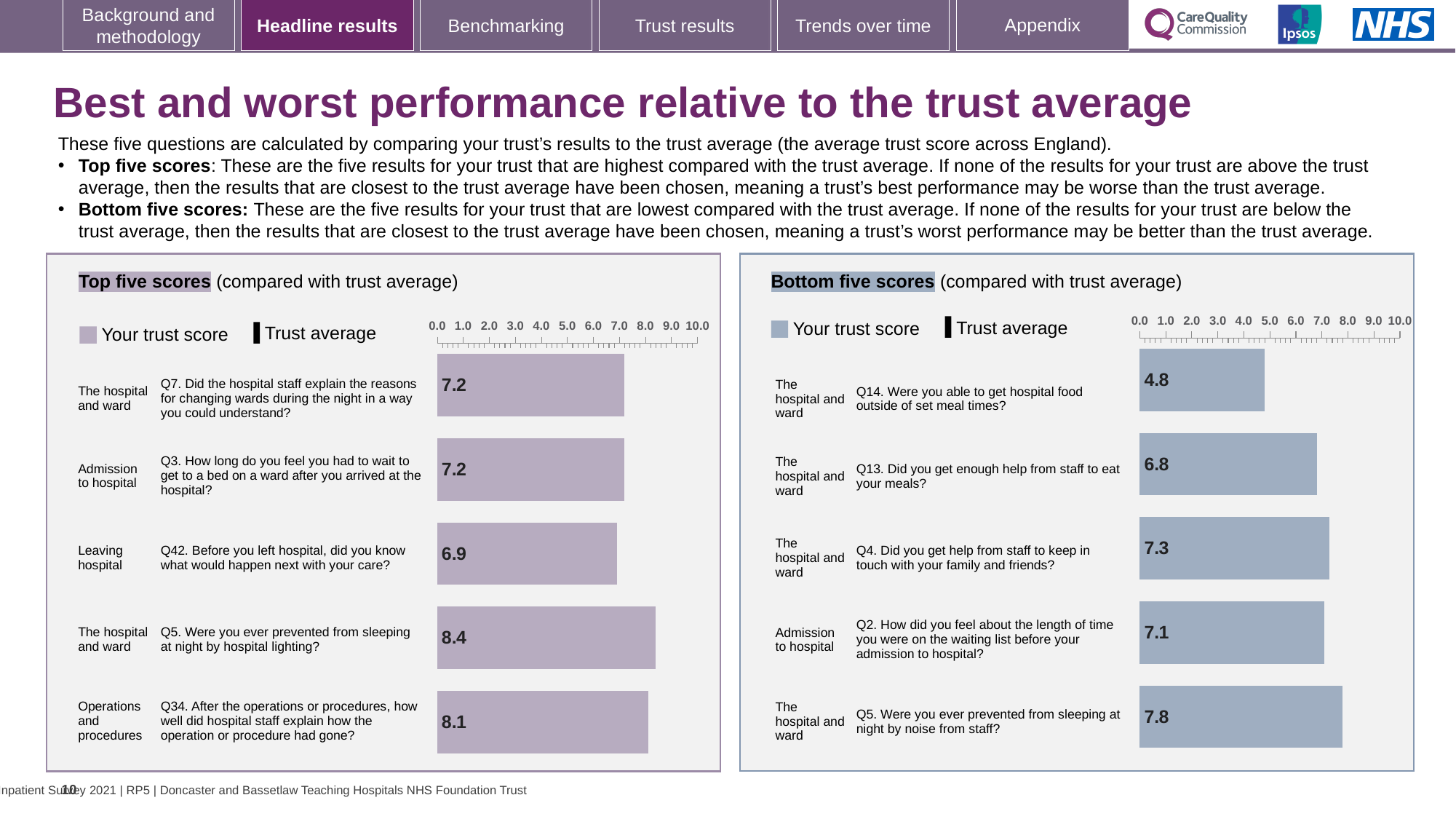
In the Bottom five scores chart, what is the difference between the score for Q5 (noise from staff) and the score for Q14 (food outside set meal times)? 3.0 In the Bottom five scores chart, which question has the lowest trust score? Q14. Were you able to get hospital food outside of set meal times? In the Top five scores chart, what is the maximum value shown on the score axis? 10.0 In the Top five scores chart, what is the difference between the score for Q5 (8.4) and the score for Q42 (6.9)? 1.5 In the Top five scores chart, what is the trust score for Q42 (Before you left hospital, did you know what would happen next with your care?)? 6.9 In the Bottom five scores chart, which has the larger score: Q13 (help from staff to eat meals) or Q4 (help to keep in touch with family and friends)? Q4 In the Top five scores chart, which question has the highest trust score? Q5. Were you ever prevented from sleeping at night by hospital lighting? In the Bottom five scores chart, what is the trust score for Q14 (Were you able to get hospital food outside of set meal times?)? 4.8 In the Bottom five scores chart, what is the trust score for Q2 about the length of time on the waiting list before admission? 7.1 How many questions are shown in the Top five scores chart? 5 In the Top five scores chart, what is the trust score for Q5 (Were you ever prevented from sleeping at night by hospital lighting?)? 8.4 What type of chart is used in the Bottom five scores panel? Bar chart